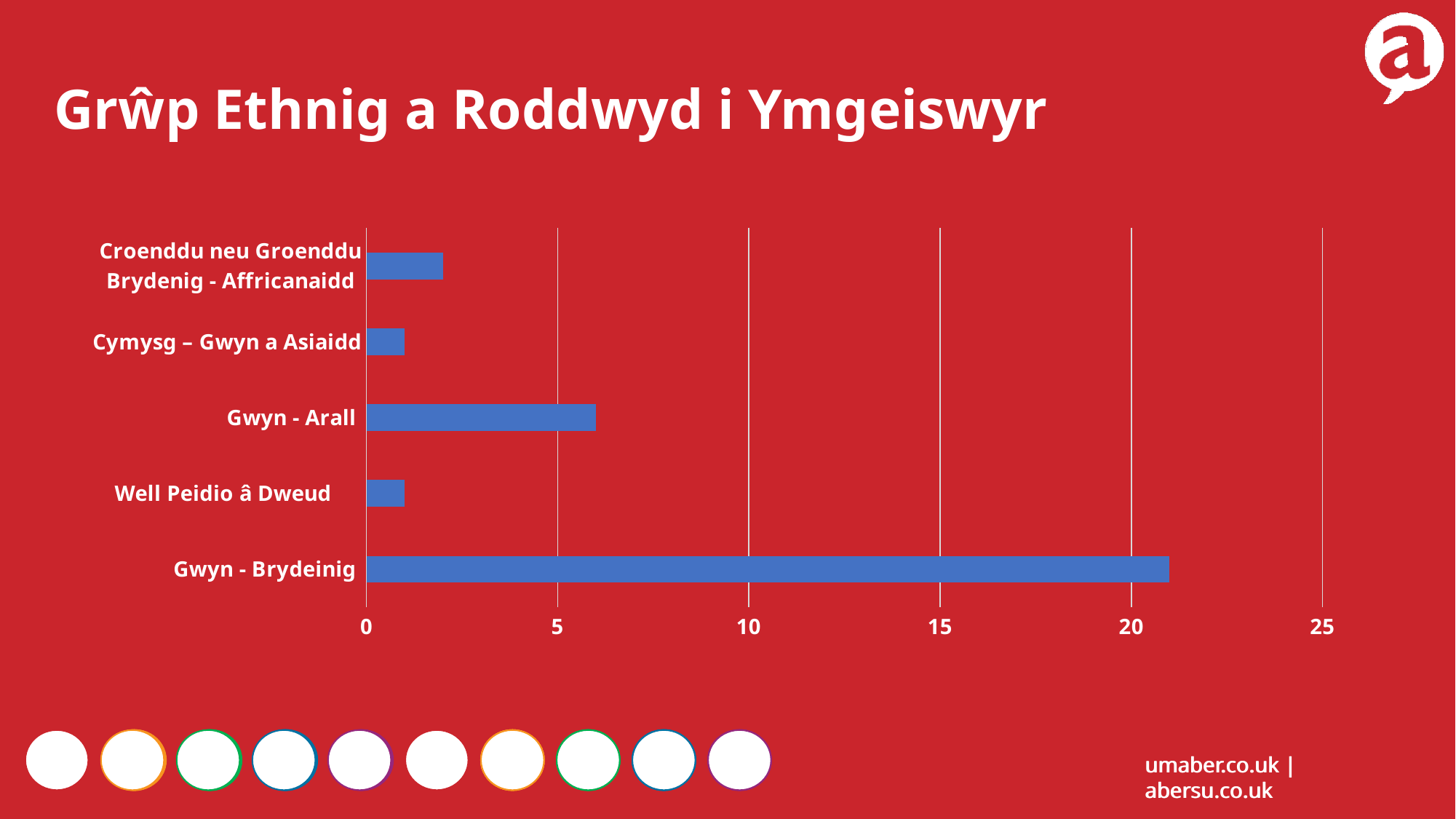
Is the value for Gwyn - Arall greater or less than 10? less Is the value for Gwyn - Brydeinig greater or less than 20? greater Is the value for Gwyn - Arall greater or less than 5? greater Which is larger, the value for Gwyn - Arall or the value for Croenddu neu Groenddu Brydenig - Affricanaidd? Gwyn - Arall How many categories are plotted in the chart? 5 Which category has the highest value? Gwyn - Brydeinig What kind of chart is shown on the slide? bar chart What is the title of the slide? Grŵp Ethnig a Roddwyd i Ymgeiswyr Which is larger, the value for Gwyn - Brydeinig or the value for Gwyn - Arall? Gwyn - Brydeinig